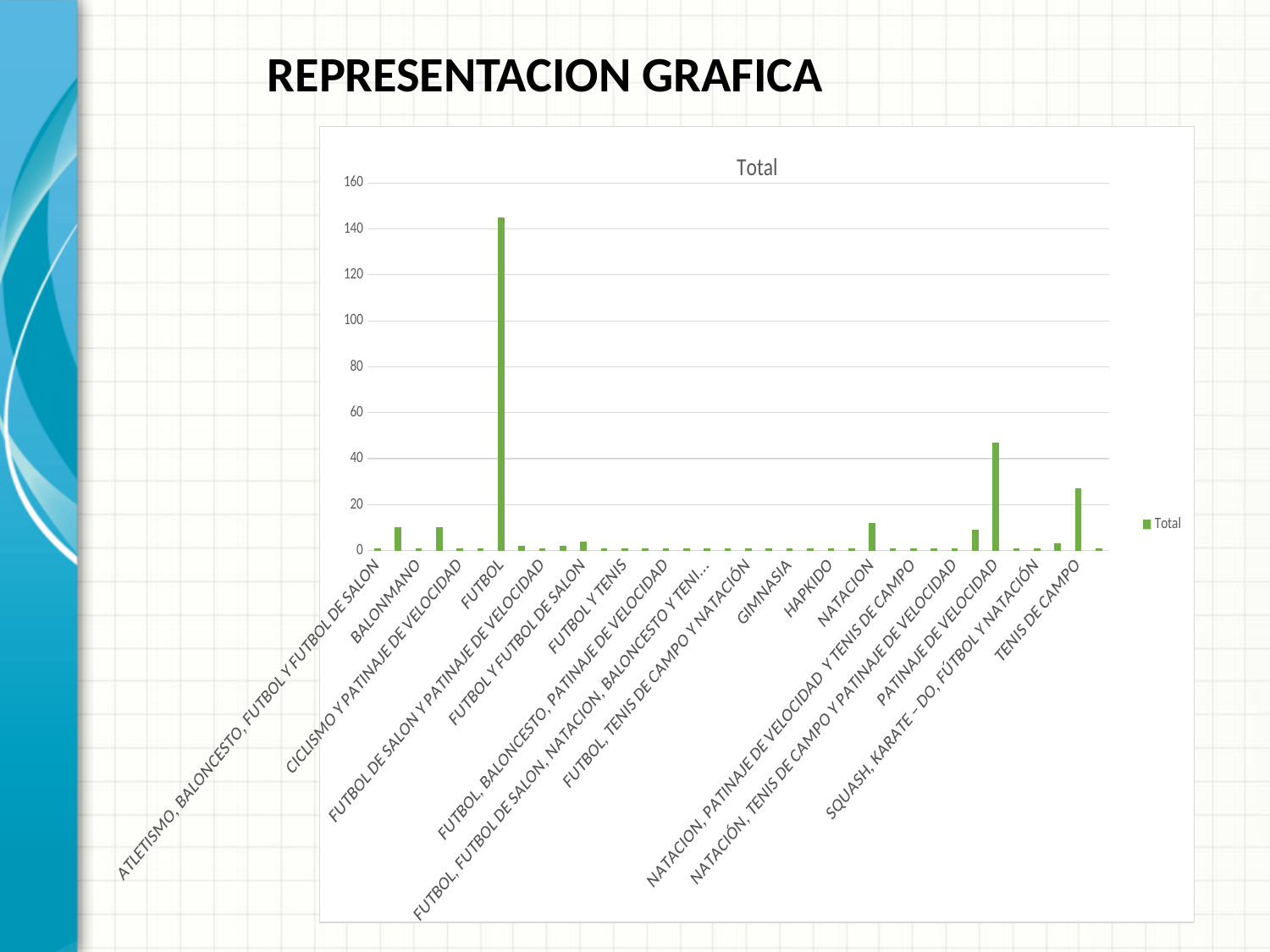
Which is larger, the value for FUTBOL or the value for PATINAJE DE VELOCIDAD? FUTBOL Is the value for PATINAJE DE VELOCIDAD greater or less than 60? less What is the title of the chart? Total Is the value for TENIS DE CAMPO greater or less than 20? greater Is the value for PATINAJE DE VELOCIDAD greater or less than 40? greater What kind of chart is shown on the slide? bar chart Which category has the highest value? FUTBOL Which is larger, the value for PATINAJE DE VELOCIDAD or the value for TENIS DE CAMPO? PATINAJE DE VELOCIDAD What colour are the bars in the chart? green How many series does the legend list? 1